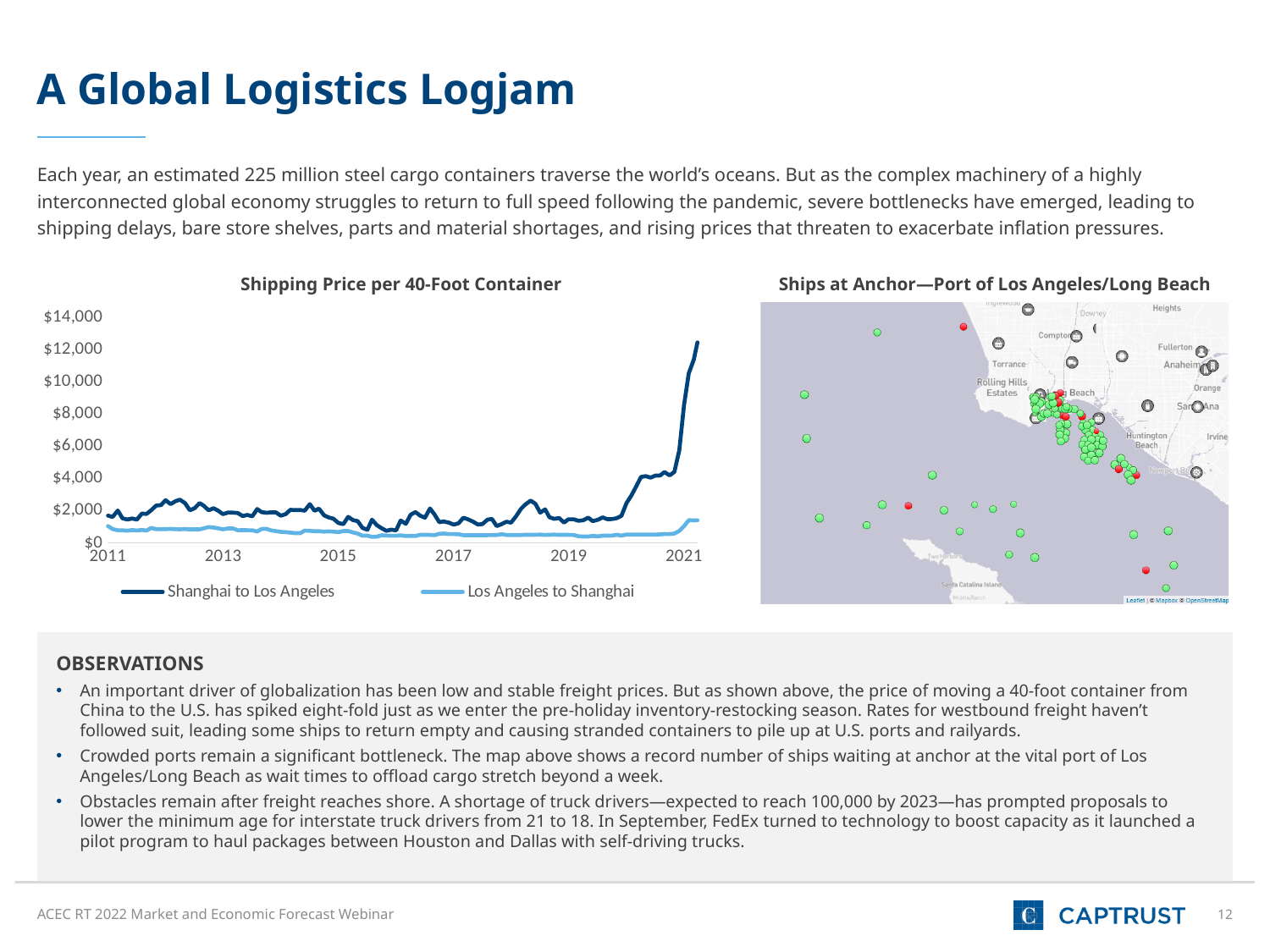
In the 'Shipping Price per 40-Foot Container' chart, what are the two series named in the legend? Shanghai to Los Angeles; Los Angeles to Shanghai How many year labels are shown on the x-axis of the 'Shipping Price per 40-Foot Container' chart? 6 In the 'Shipping Price per 40-Foot Container' chart, is the Los Angeles to Shanghai value in 2021 greater or less than $2,000? less What is the highest value labelled on the y-axis of the 'Shipping Price per 40-Foot Container' chart? $14,000 In the 'Shipping Price per 40-Foot Container' chart, which series stays lower across the whole period shown? Los Angeles to Shanghai In the 'Shipping Price per 40-Foot Container' chart, does the Shanghai to Los Angeles series rise or fall between 2019 and 2021? Rises In the 'Shipping Price per 40-Foot Container' chart, which series is higher in 2021, Shanghai to Los Angeles or Los Angeles to Shanghai? Shanghai to Los Angeles What type of chart is 'Shipping Price per 40-Foot Container'? Line chart How many series does the legend of the 'Shipping Price per 40-Foot Container' chart list? 2 In the 'Shipping Price per 40-Foot Container' chart, is the Shanghai to Los Angeles value at the end of 2021 greater or less than $10,000? greater In the 'Shipping Price per 40-Foot Container' chart, in which year does the Shanghai to Los Angeles series reach its highest point? 2021 In the 'Shipping Price per 40-Foot Container' chart, is the Shanghai to Los Angeles value in 2011 greater or less than $4,000? less